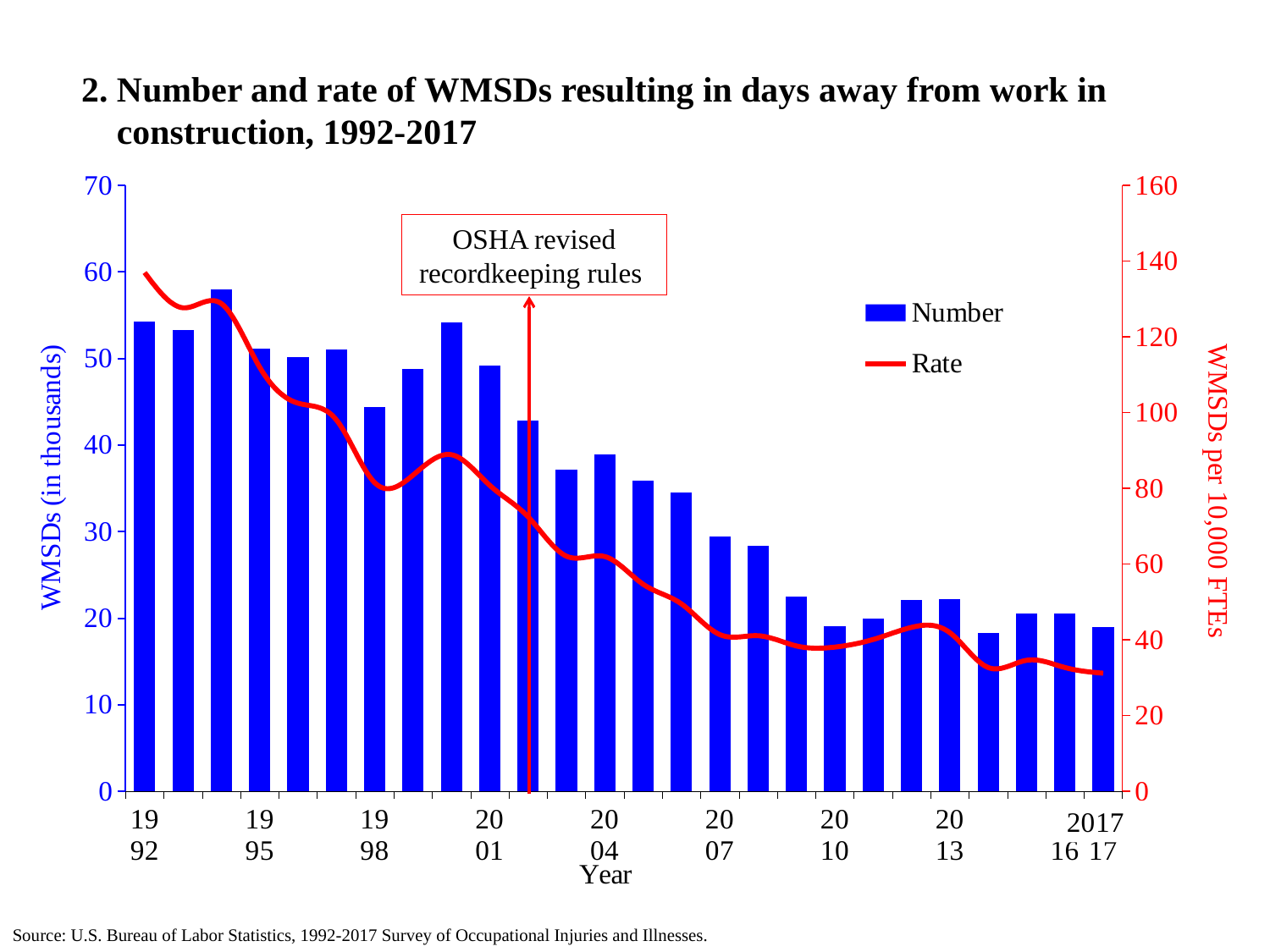
In which year is the WMSD rate (red line) highest? 1992 Which year has the larger number of WMSDs, 1992 or 2017? 1992 How many series does the legend list? 2 What kind of chart is shown on the slide? A combined bar and line chart Is the WMSD rate for 2017 greater or less than 40 per 10,000 FTEs? less How many years (bars) are plotted in the chart? 26 Is the WMSD rate for 1992 greater or less than 120 per 10,000 FTEs? greater Overall, does the number of WMSDs rise or fall from 1992 to 2017? fall Is the number of WMSDs for 1992 greater or less than 50 thousand? greater Which year has the highest number of WMSDs (tallest bar)? 1994 What event does the annotation with the red arrow mark on the chart? OSHA revised recordkeeping rules